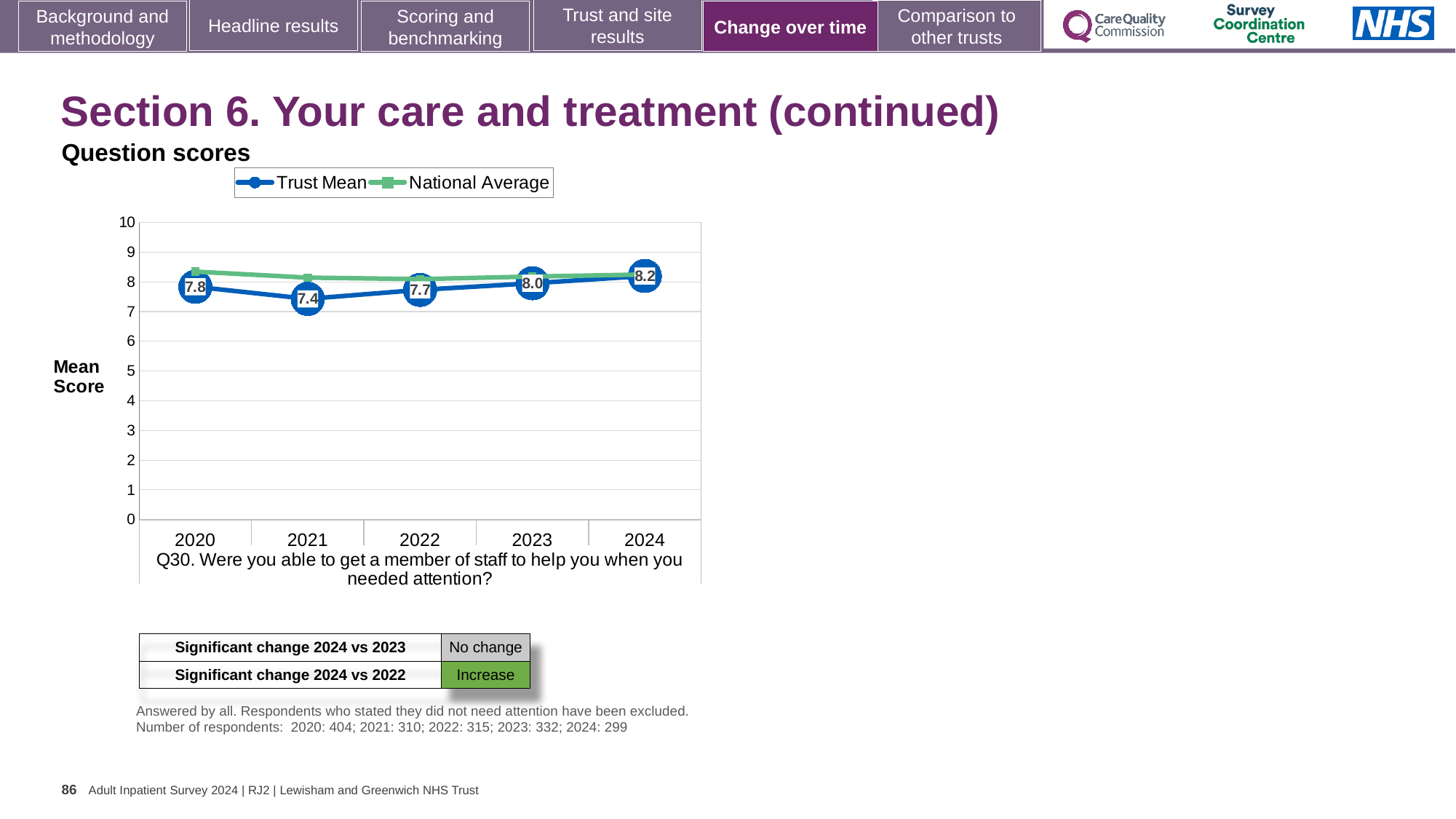
What is the Trust Mean score for 2024? 8.2 How many series does the chart legend list? 2 In which year is the Trust Mean score highest? 2024 What is the difference between the Trust Mean scores for 2024 and 2021? 0.8 What is the Trust Mean score for 2021? 7.4 Does the Trust Mean score rise or fall from 2021 to 2024? Rise How many years are shown on the x axis of the chart? 5 Which is larger, the Trust Mean score for 2023 or for 2022? 2023 In which year is the Trust Mean score lowest? 2021 What is the Trust Mean score for 2020? 7.8 What kind of chart is shown on the slide? Line chart Is the National Average value for 2020 greater or less than 8? greater